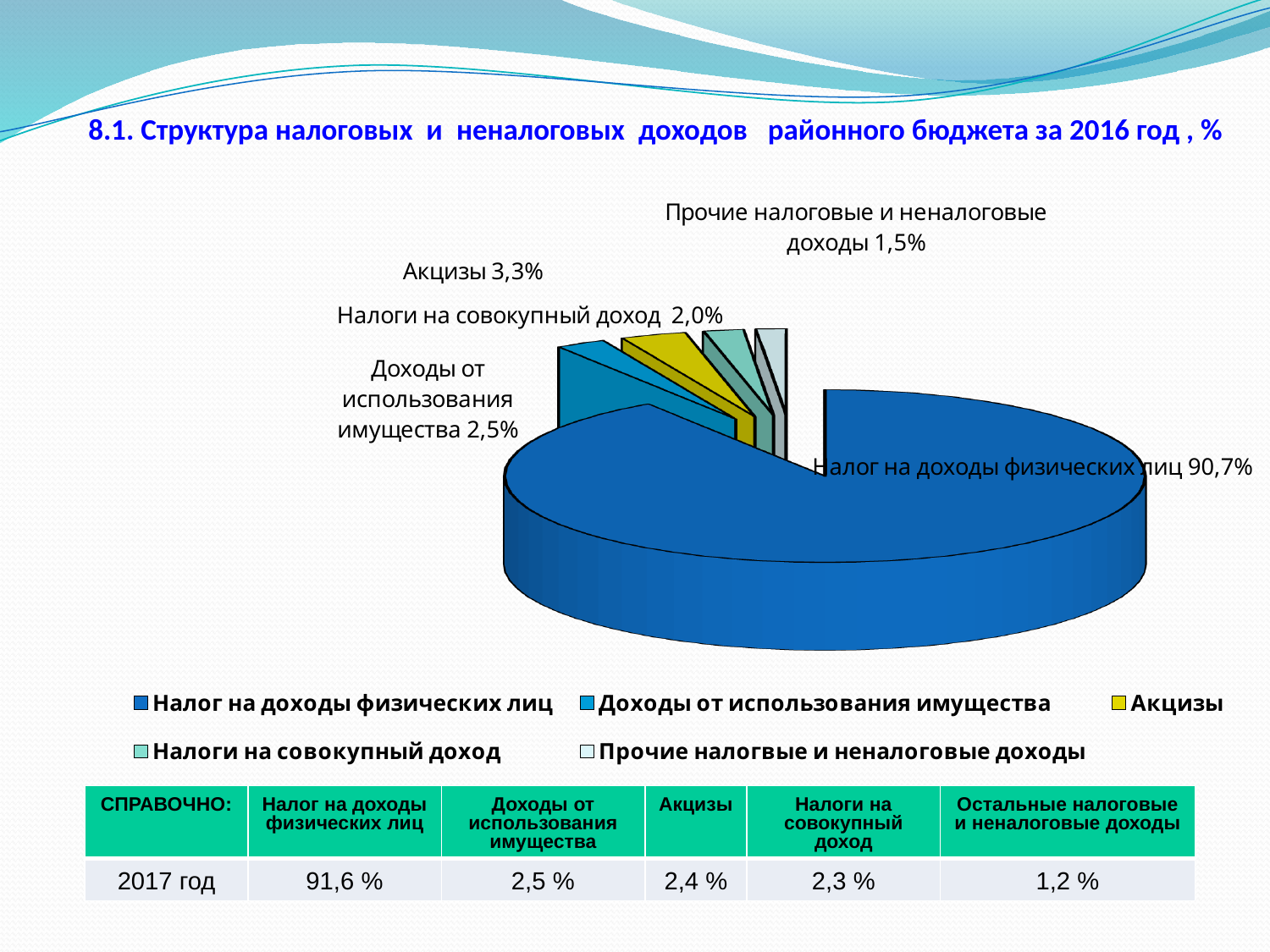
What type of chart is shown on the slide? Pie chart What is the value shown for "Доходы от использования имущества"? 2,5% What share of the pie does "Налог на доходы физических лиц" have? 90,7% What is the value shown for "Налоги на совокупный доход"? 2,0% What is the difference between the shares of "Акцизы" and "Налоги на совокупный доход"? 1,3% Which is larger: the share of "Акцизы" or the share of "Доходы от использования имущества"? Акцизы Which category has the smallest slice of the pie? Прочие налоговые и неналоговые доходы Which category has the largest slice of the pie? Налог на доходы физических лиц How many slices does the pie chart have? 5 What is the value shown for "Акцизы"? 3,3% What is the value shown for "Прочие налоговые и неналоговые доходы"? 1,5% What is the title of the chart? 8.1. Структура налоговых и неналоговых доходов районного бюджета за 2016 год , %